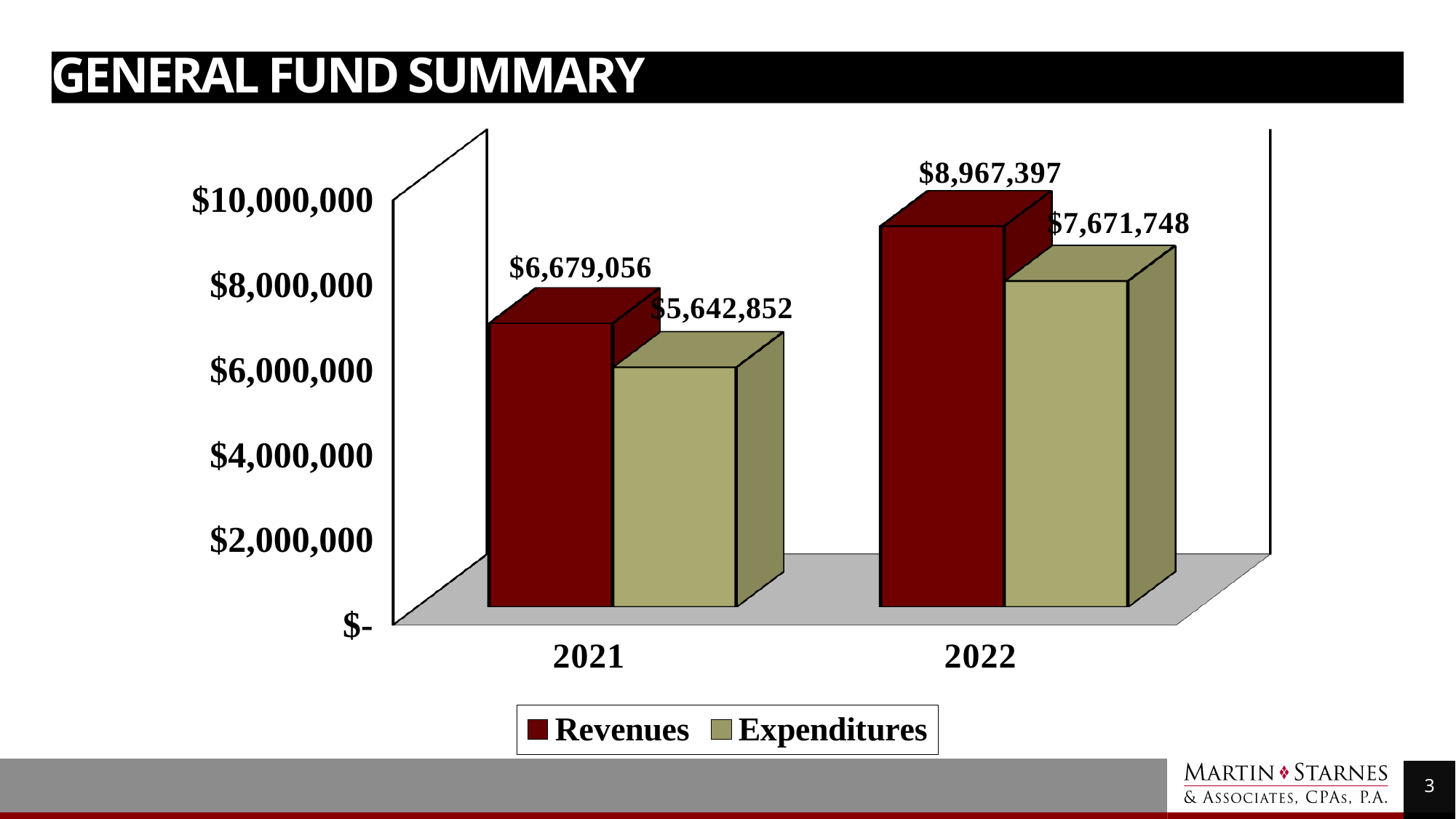
Which year had the highest Revenues? 2022 What is the difference between Revenues and Expenditures in 2022? $1,295,649 Which bar shows the lowest value on the chart? Expenditures in 2021 How many series does the legend list? 2 What were the Revenues in 2021? $6,679,056 Which was larger in 2021, Revenues or Expenditures? Revenues By how much did Revenues increase from 2021 to 2022? $2,288,341 Is the value for Expenditures in 2022 greater or less than $8,000,000? less What were the Expenditures in 2021? $5,642,852 How many years are shown on the x axis? 2 What were the Expenditures in 2022? $7,671,748 What kind of chart is shown on the slide? Bar chart